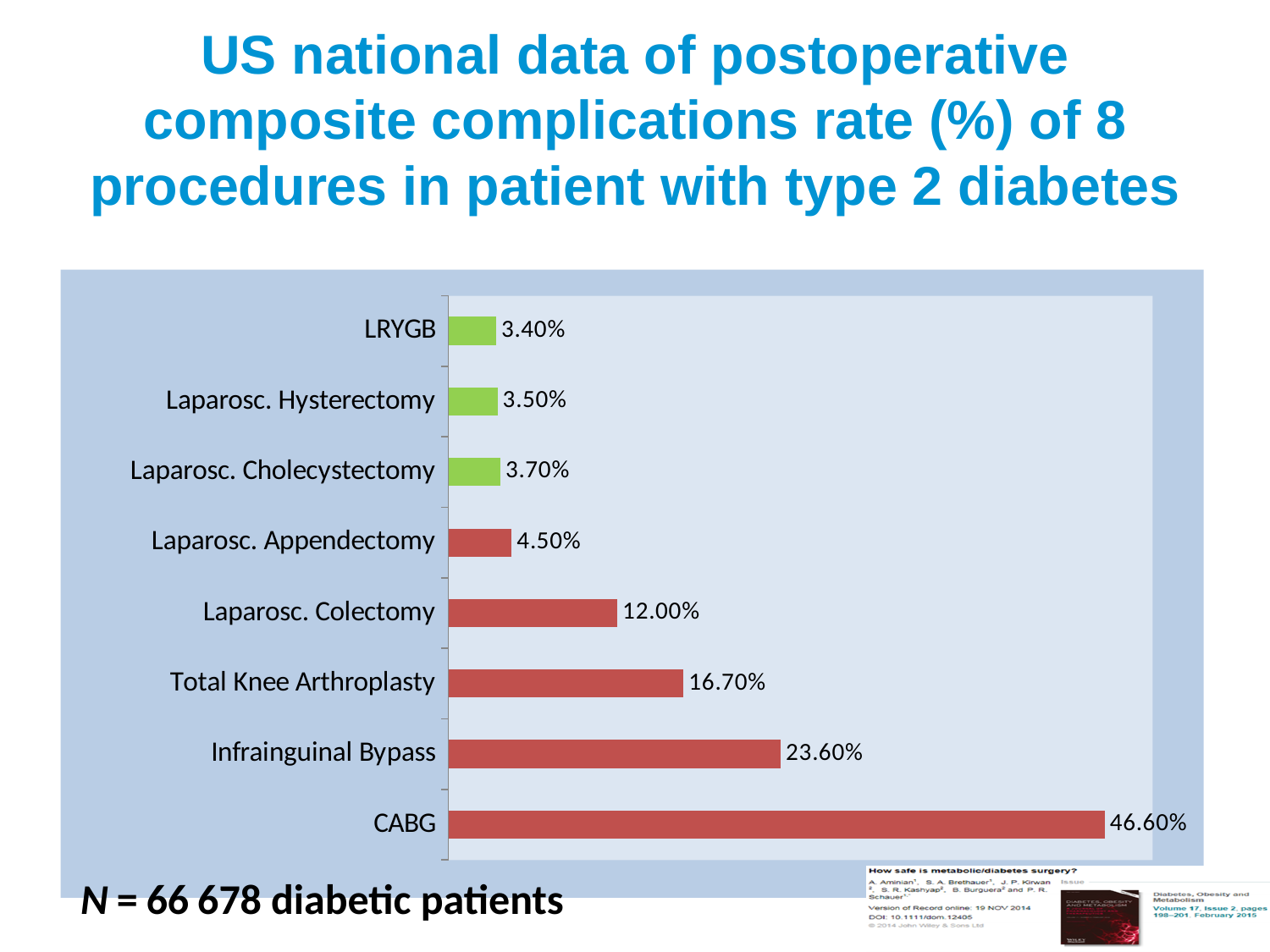
How many diabetic patients does the slide say the data is based on? 66 678 Which procedure has the lowest complication rate? LRYGB Which has a higher complication rate, Laparosc. Colectomy or Total Knee Arthroplasty? Total Knee Arthroplasty What is the complication rate for LRYGB? 3.40% What is the complication rate for CABG? 46.60% How many procedures are shown in the chart? 8 What is the complication rate for Laparosc. Colectomy? 12.00% Which procedure has the highest complication rate? CABG What is the difference between the complication rates of CABG and Infrainguinal Bypass? 23.00% What is the difference between the complication rates of Total Knee Arthroplasty and Laparosc. Appendectomy? 12.20% Which has a higher complication rate, Laparosc. Cholecystectomy or Laparosc. Appendectomy? Laparosc. Appendectomy What kind of chart is shown on the slide? Bar chart